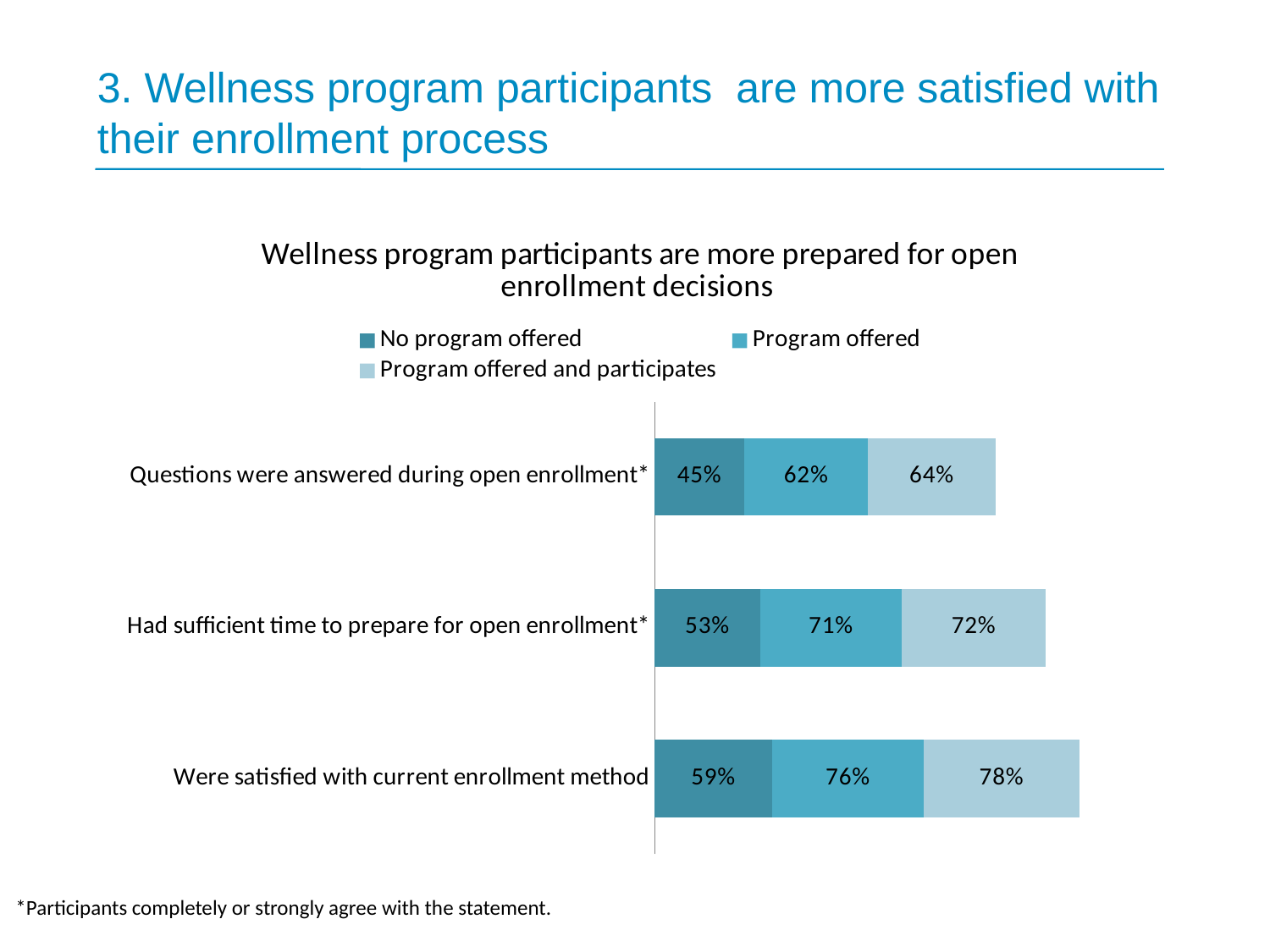
For 'Had sufficient time to prepare for open enrollment*', which is larger: 'No program offered' or 'Program offered'? Program offered What is the total of the stacked bar for 'Questions were answered during open enrollment*'? 171% Which category has the lowest value for the 'Program offered and participates' series? Questions were answered during open enrollment* What percentage of the 'No program offered' group were satisfied with current enrollment method? 59% What is the title of the chart? Wellness program participants are more prepared for open enrollment decisions How many series does the legend list? 3 What is the value for 'Program offered and participates' for 'Had sufficient time to prepare for open enrollment*'? 72% What kind of chart is shown on the slide? Stacked bar chart How many categories are shown on the chart? 3 What is the difference between the 'Program offered and participates' and 'No program offered' values for 'Were satisfied with current enrollment method'? 19% What is the value for 'Program offered' for 'Questions were answered during open enrollment*'? 62% Which category has the highest value for the 'No program offered' series? Were satisfied with current enrollment method